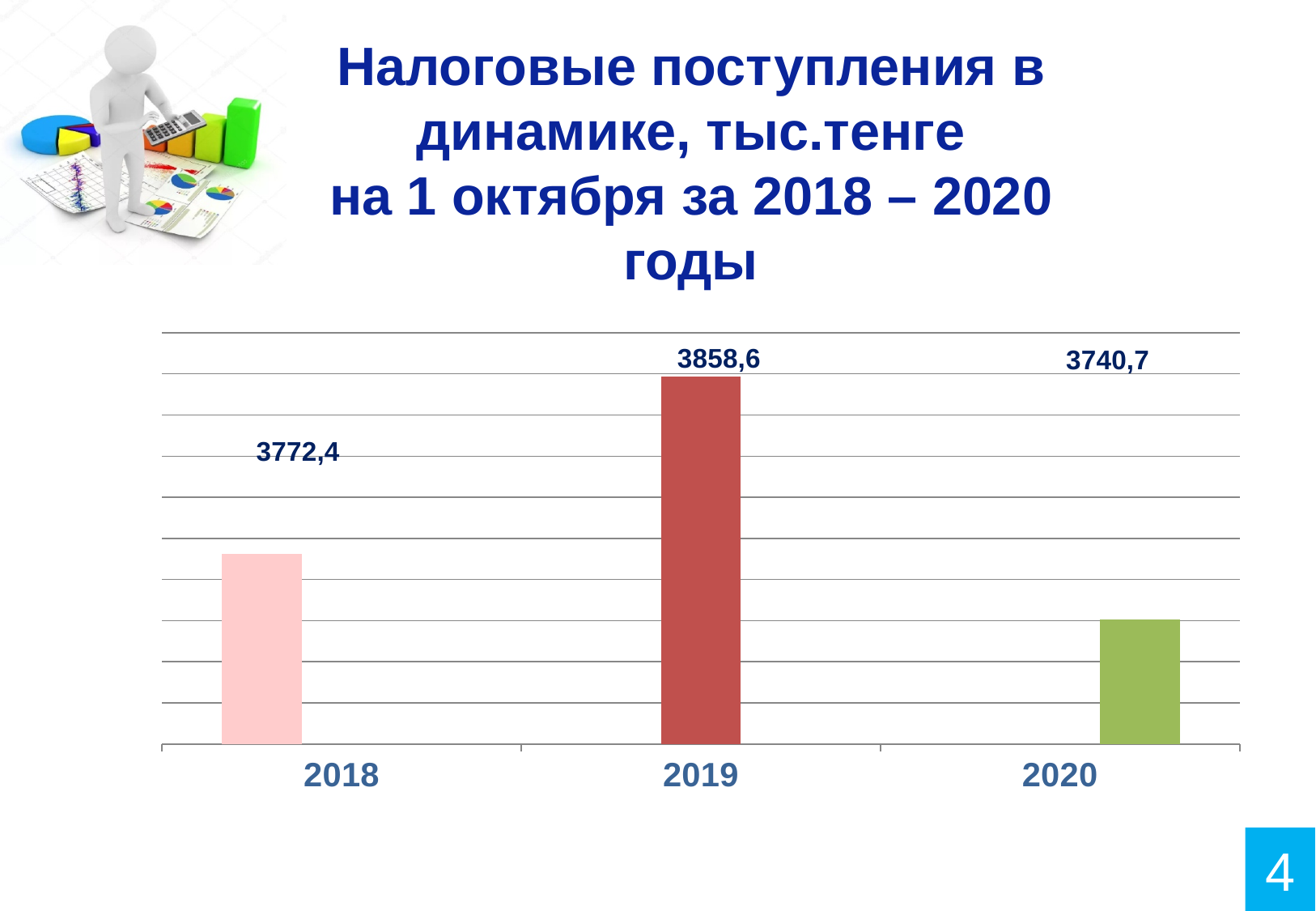
What is the value for 2018? 3772,4 What is the difference between the values for 2019 and 2018? 86,2 Does the value rise or fall from 2019 to 2020? fall What is the value for 2020? 3740,7 Which is larger, the value for 2018 or the value for 2020? 2018 What is the difference between the values for 2019 and 2020? 117,9 How many years are shown on the x axis? 3 What is the difference between the values for 2018 and 2020? 31,7 What is the value for 2019? 3858,6 What kind of chart is shown on the slide? bar chart Which year has the lowest value? 2020 Which year has the highest value? 2019